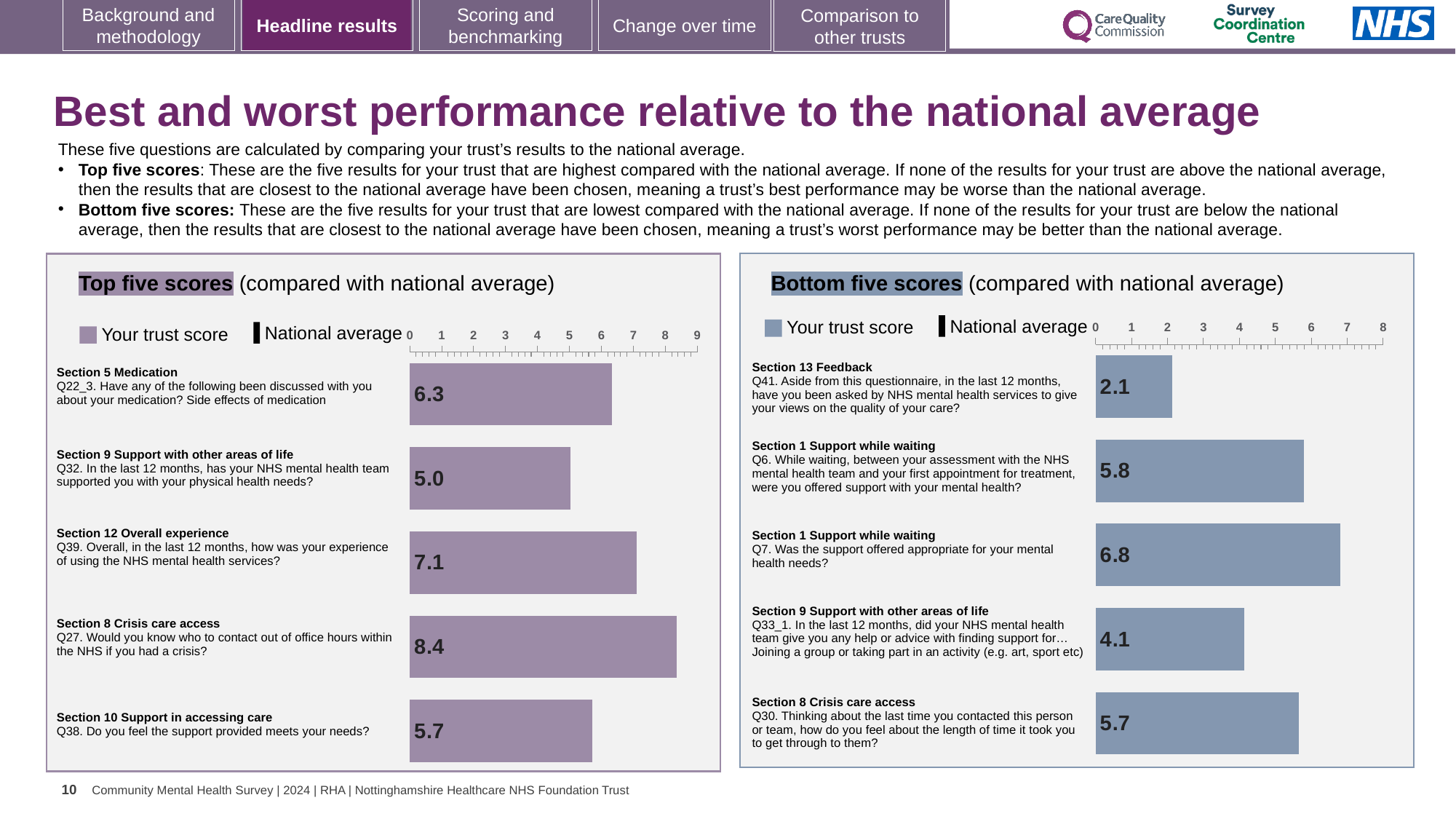
In the 'Bottom five scores' chart, which has the larger trust score, Q6 or Q30? Q6 How many entries does the legend of the 'Bottom five scores' chart list? 2 In the 'Top five scores' chart, what is the trust score for Q32 (supported you with your physical health needs)? 5.0 In the 'Bottom five scores' chart, what is the trust score for Q7 (Was the support offered appropriate for your mental health needs?)? 6.8 What type of chart is the 'Top five scores' chart? Bar chart In the 'Top five scores' chart, is the trust score for Q39 greater or less than 6? greater In the 'Top five scores' chart, which question has the highest trust score? Q27 (Section 8 Crisis care access) In the 'Top five scores' chart, what is the trust score for Q27 (Would you know who to contact out of office hours within the NHS if you had a crisis?)? 8.4 In the 'Top five scores' chart, what is the difference between the trust scores for Q27 and Q38? 2.7 In the 'Bottom five scores' chart, what is the trust score for Q41 (asked by NHS mental health services to give your views on the quality of your care)? 2.1 How many bars are plotted in the 'Bottom five scores' chart? 5 In the 'Bottom five scores' chart, which question has the lowest trust score? Q41 (Section 13 Feedback)